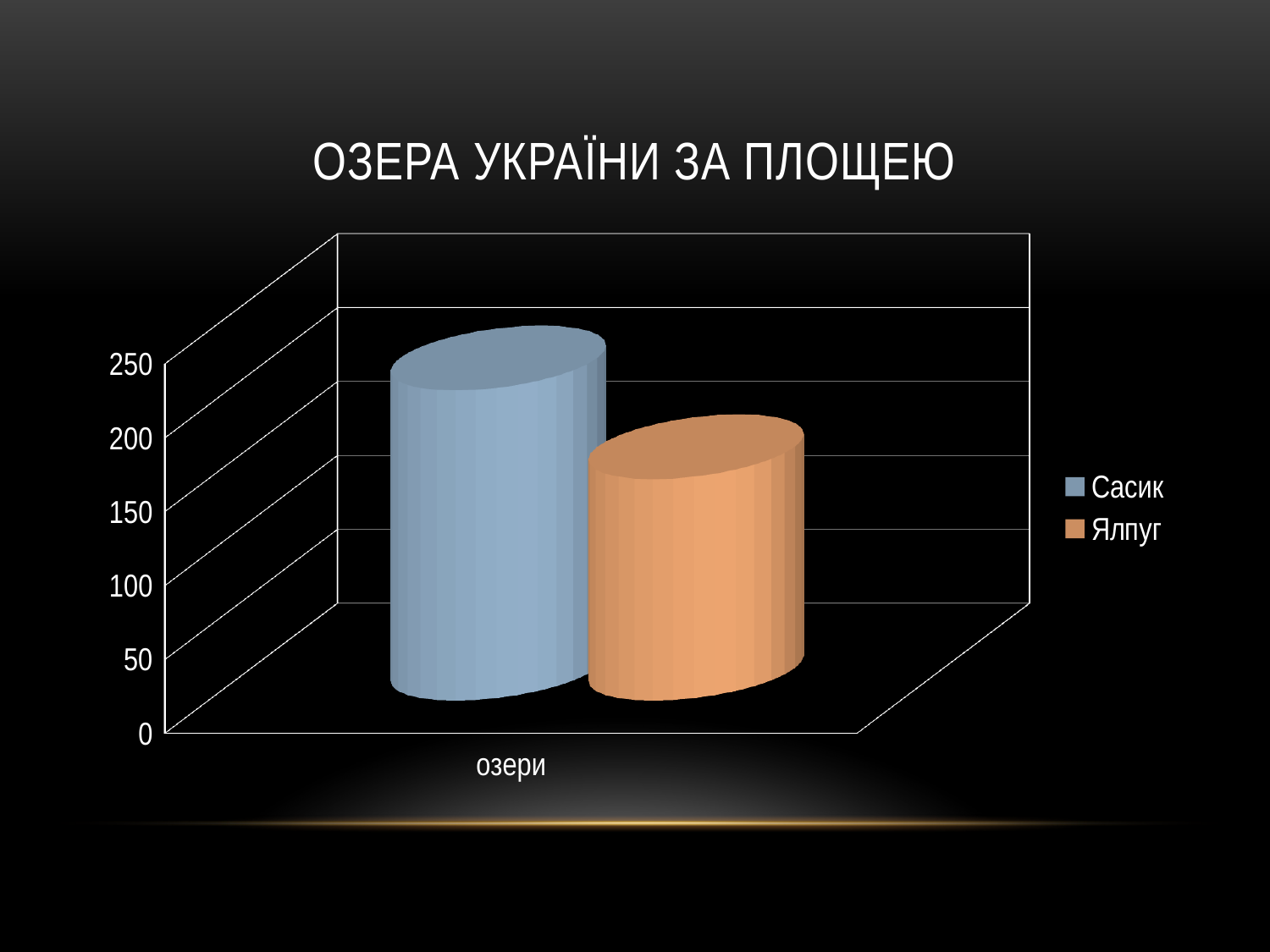
Is the value for Сасик greater or less than 150? greater Which series has the lowest value? Ялпуг What is the title of the chart? ОЗЕРА УКРАЇНИ ЗА ПЛОЩЕЮ Is the value for Сасик greater or less than 250? less How many series does the legend list? 2 What kind of chart is shown on the slide? bar chart Which is larger, the value for Сасик or the value for Ялпуг? Сасик How many categories are shown on the x axis? 1 What is the label of the category on the x axis? озери Which series has the highest value? Сасик Is the value for Ялпуг greater or less than 200? less